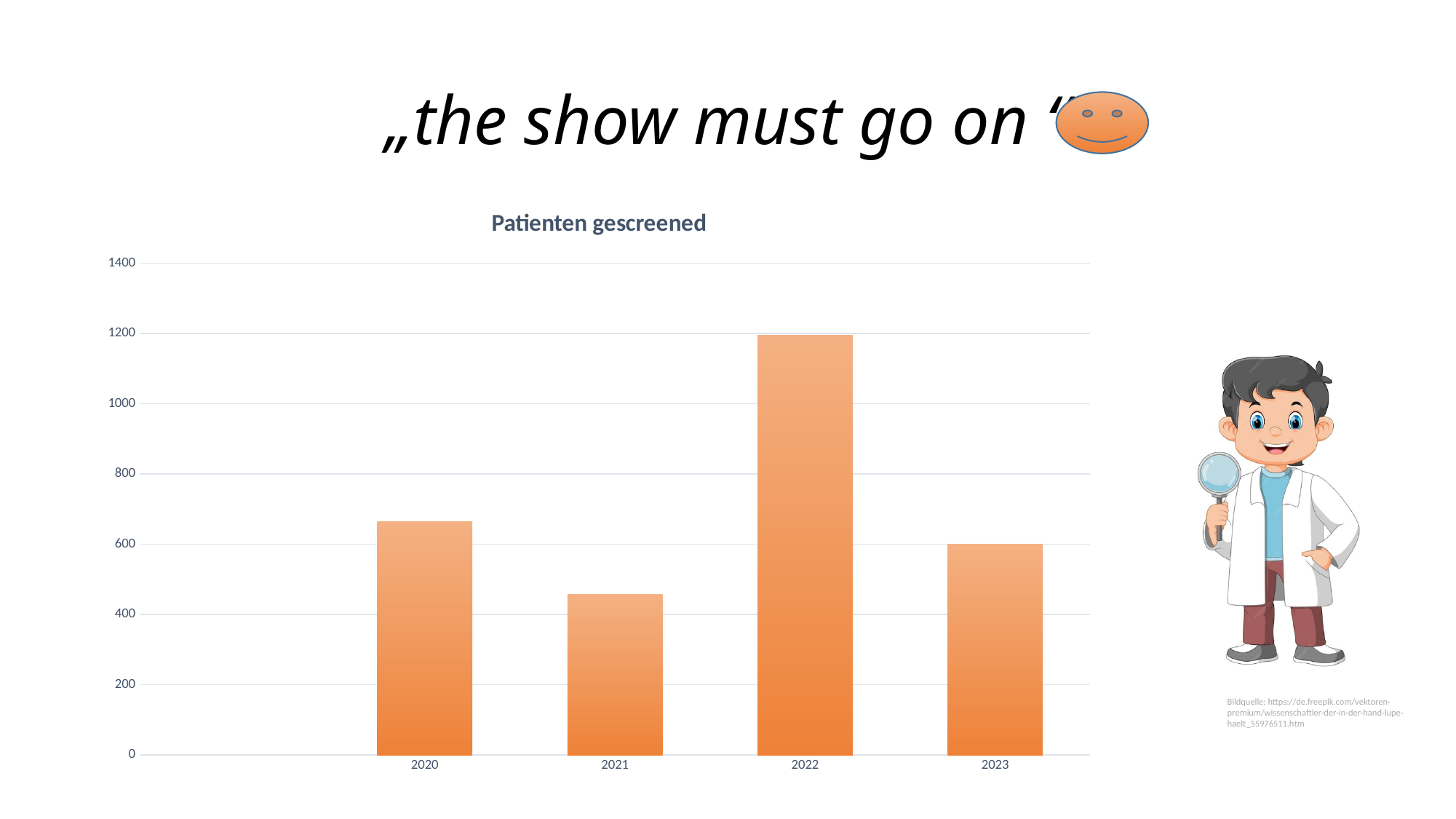
Is the value for 2022 greater or less than 1000? greater Which year has the highest number of patients screened? 2022 Is the value for 2021 greater or less than 600? less What is the title of the chart? Patienten gescreened What is the highest value shown on the y axis of the chart? 1400 How many years are shown on the x axis of the chart? 4 Is the value for 2023 greater or less than 800? less What kind of chart is shown on the slide? bar chart Which year has a larger value, 2020 or 2023? 2020 Which year has the lowest number of patients screened? 2021 Did the number of patients screened rise or fall from 2022 to 2023? fall